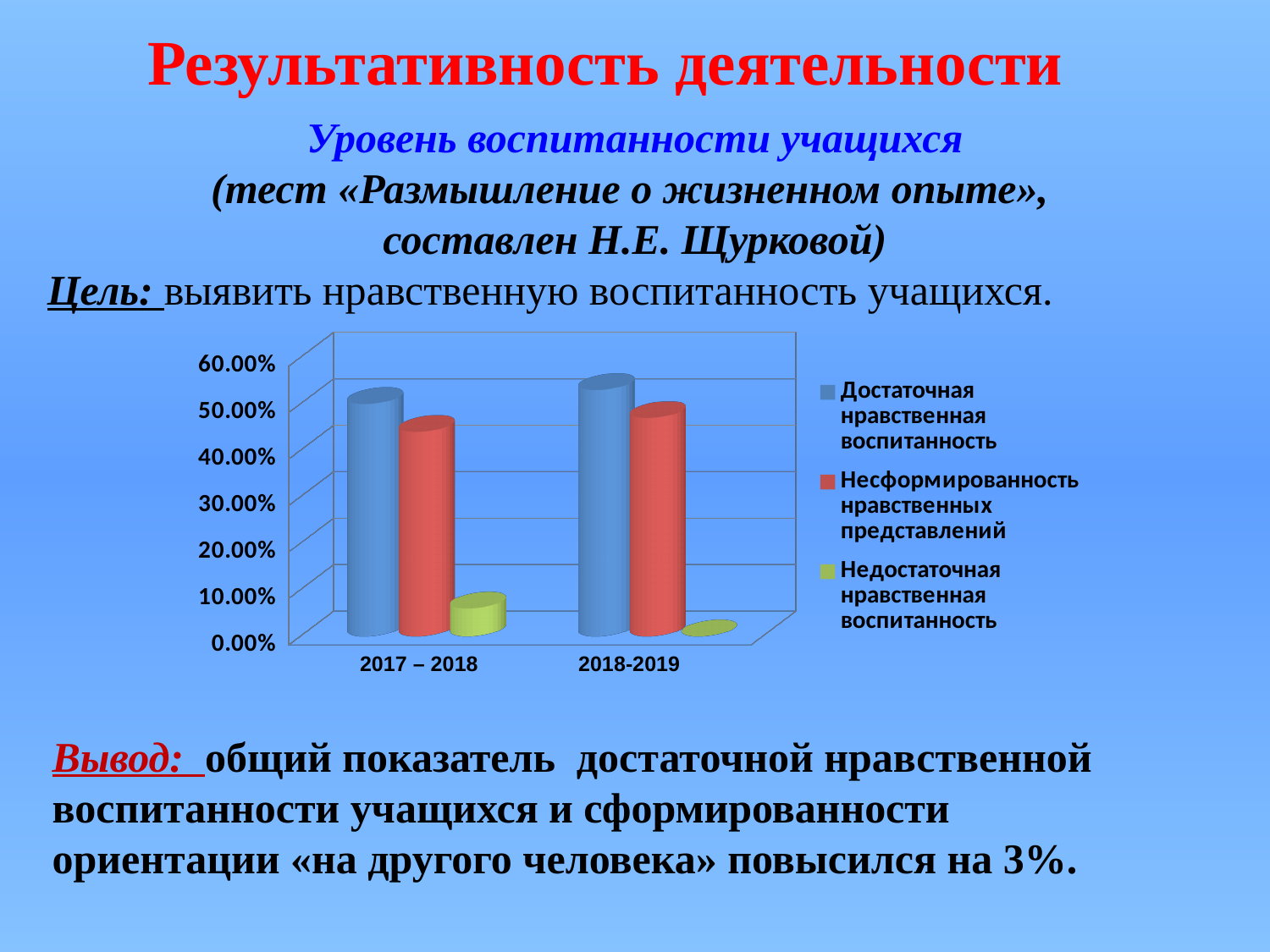
How many categories (school years) are shown on the x axis of the chart? 2 How many series does the chart legend list? 3 Is the value for Несформированность нравственных представлений in 2018-2019 greater or less than 30.00%? greater Does the value for Достаточная нравственная воспитанность rise or fall from 2017 – 2018 to 2018-2019? rise For 2017 – 2018, which is larger: Достаточная нравственная воспитанность or Несформированность нравственных представлений? Достаточная нравственная воспитанность Is the value for Достаточная нравственная воспитанность in 2017 – 2018 greater or less than 40.00%? greater What kind of chart is shown on the slide? bar chart Does the value for Недостаточная нравственная воспитанность rise or fall from 2017 – 2018 to 2018-2019? fall What colour represents the series Несформированность нравственных представлений in the chart? red Is the value for Недостаточная нравственная воспитанность in 2017 – 2018 greater or less than 10.00%? less Which series has the highest value for 2017 – 2018? Достаточная нравственная воспитанность Which series has the lowest value for 2018-2019? Недостаточная нравственная воспитанность